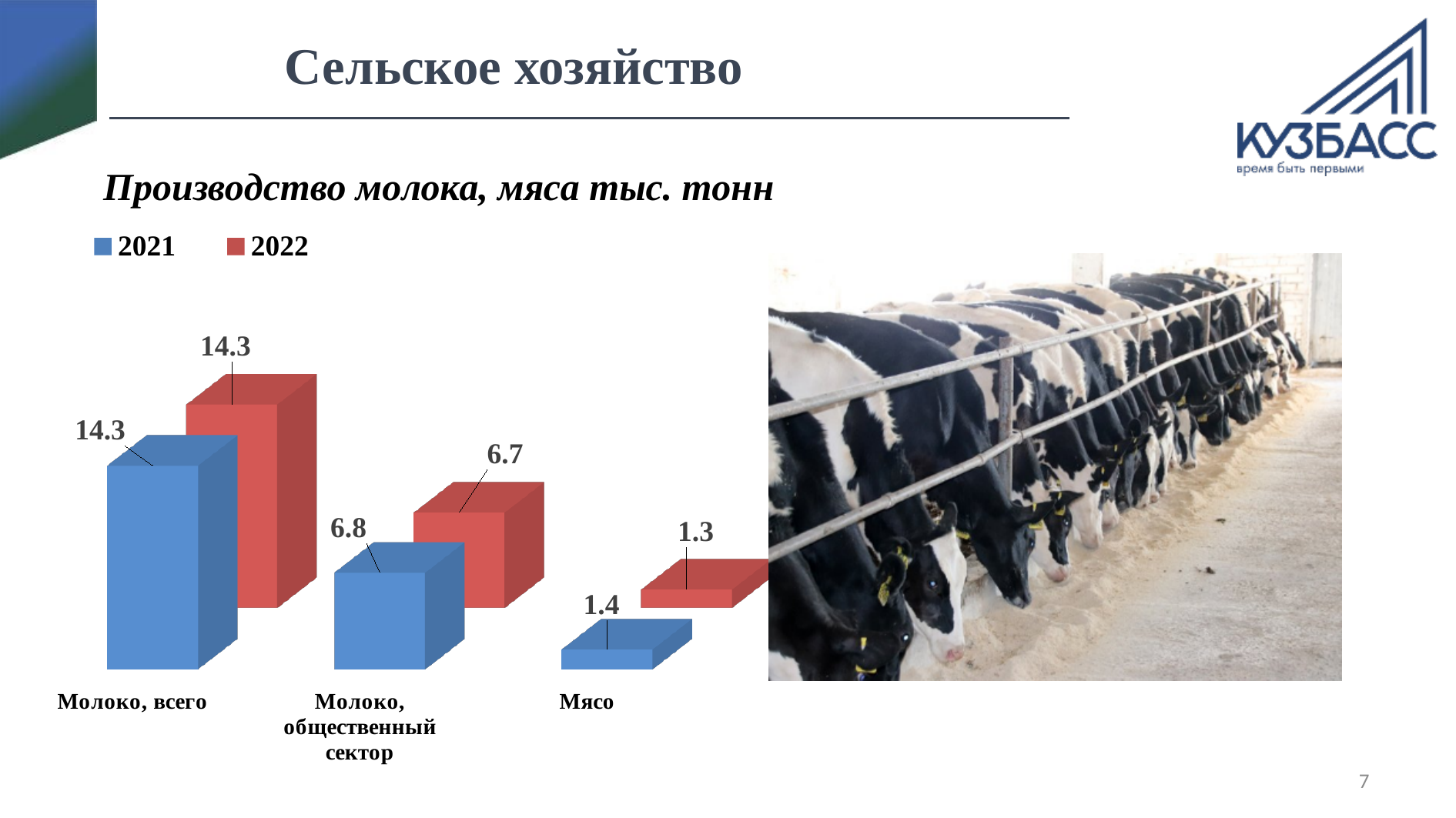
What is the 2022 value for Мясо? 1.3 Which category has the highest value in 2021? Молоко, всего What type of chart is shown on the slide? Bar chart Which is larger in 2021: Молоко, общественный сектор or Мясо? Молоко, общественный сектор What is the difference between the 2021 and 2022 values for Молоко, общественный сектор? 0.1 Which category has the lowest value in 2022? Мясо What is the 2021 value for Мясо? 1.4 How many categories are shown on the chart? 3 What is the 2022 value for Молоко, общественный сектор? 6.7 How many series does the legend list? 2 What is the 2021 value for Молоко, всего? 14.3 What is the difference between the 2021 values for Молоко, всего and Мясо? 12.9